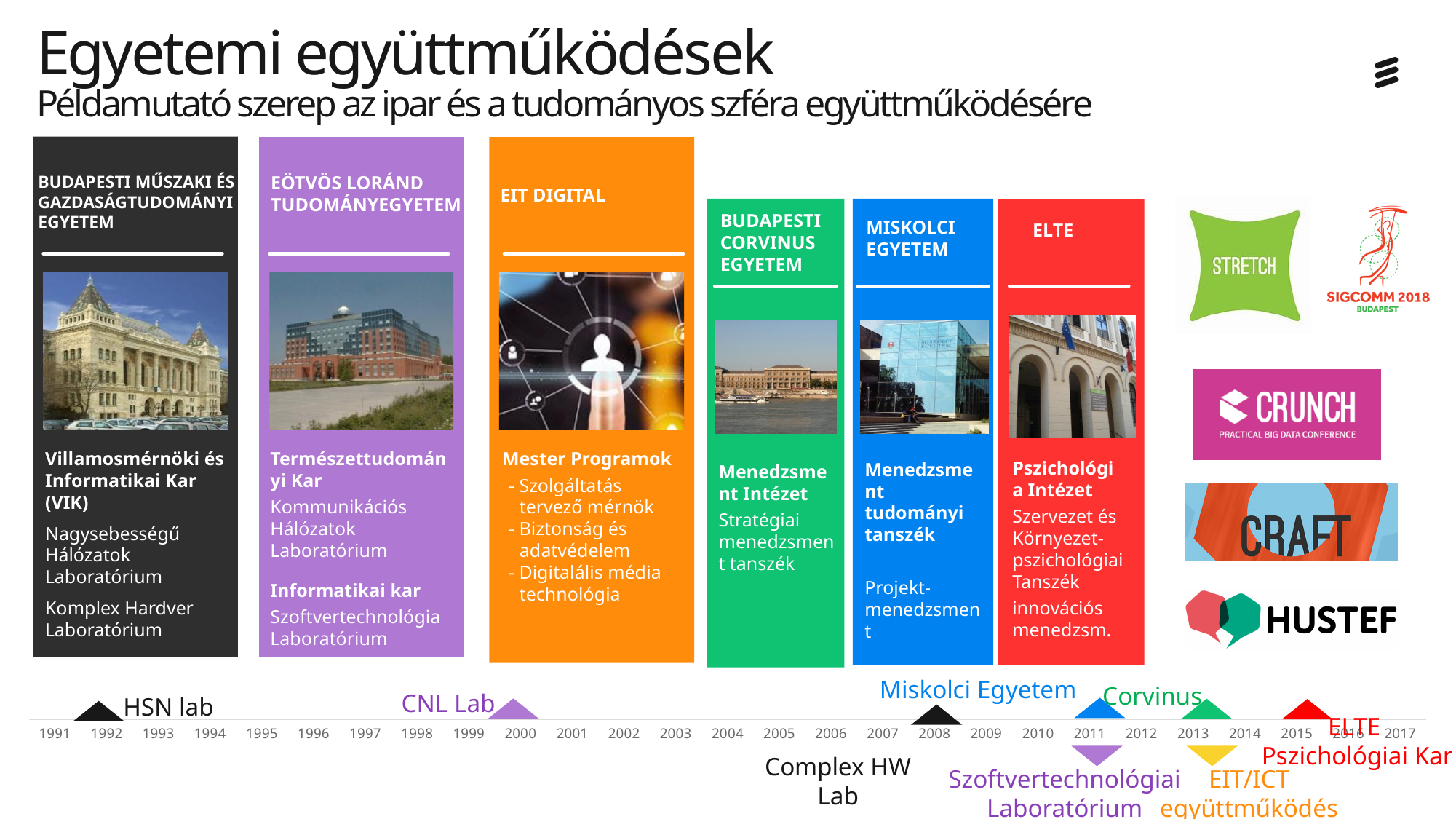
On the timeline at the bottom of the slide, what are the first and last years shown on the axis? 1991 and 2017 On the timeline at the bottom of the slide, in which year is Corvinus marked? 2013 On the timeline at the bottom of the slide, in which year is EIT/ICT együttműködés marked? 2013 On the timeline at the bottom of the slide, in which year is Miskolci Egyetem marked? 2011 On the timeline at the bottom of the slide, in which year is CNL Lab marked? 2000 On the timeline at the bottom of the slide, which event is marked earliest? HSN lab On the timeline at the bottom of the slide, in which year is HSN lab marked? 1992 On the timeline at the bottom of the slide, which event is marked latest? ELTE Pszichológiai Kar On the timeline at the bottom of the slide, in which year is Complex HW Lab marked? 2008 On the timeline at the bottom of the slide, in which year is ELTE Pszichológiai Kar marked? 2015 On the timeline at the bottom of the slide, how many years separate the HSN lab marker from the CNL Lab marker? 8 On the timeline at the bottom of the slide, how many event markers are placed along the axis? 8